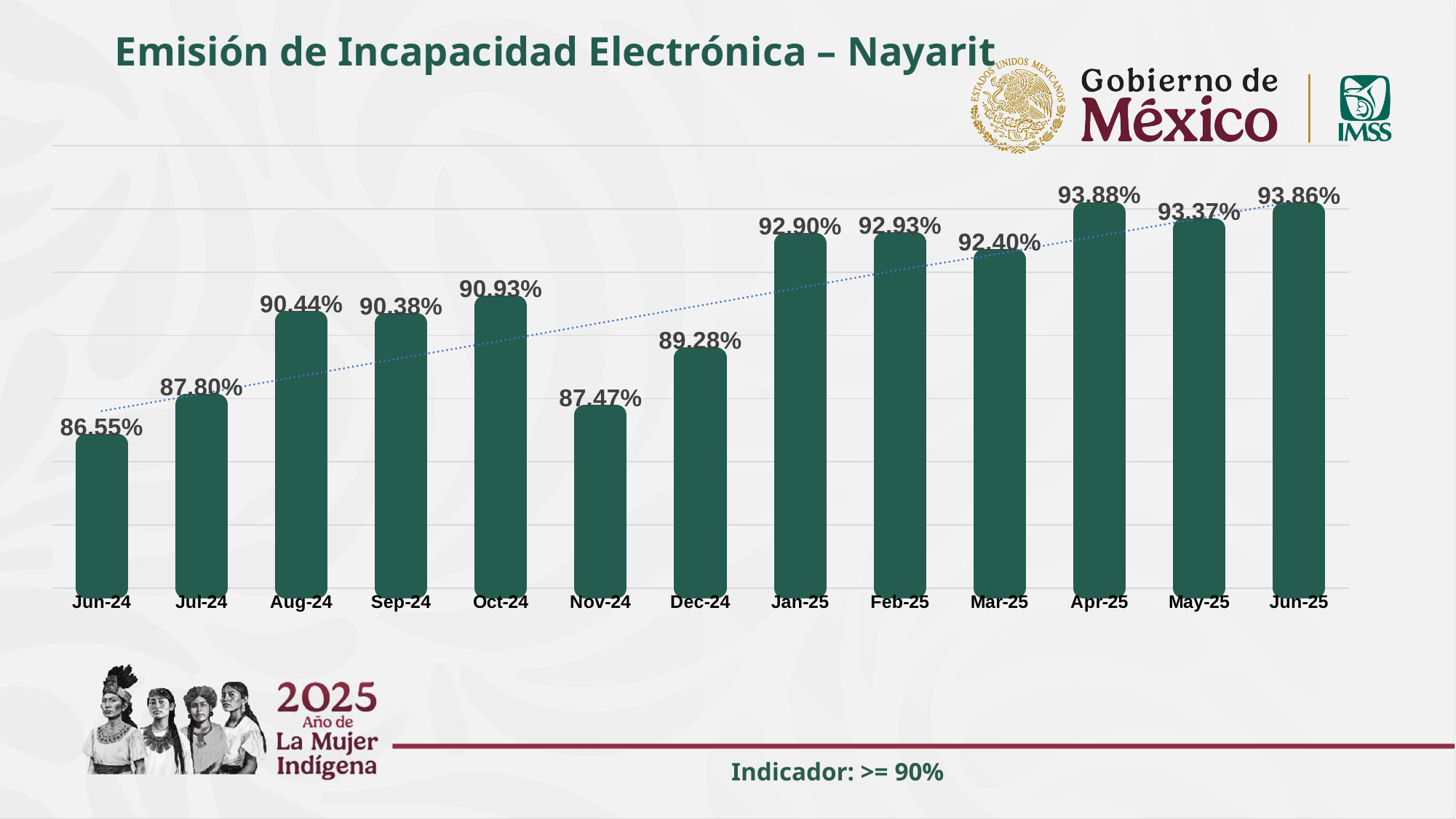
How many months are shown on the x axis? 13 What is the title of the chart? Emisión de Incapacidad Electrónica – Nayarit Which month has the lowest value? Jun-24 What is the value for Jun-25? 93.86% What is the difference between the values for Jun-25 and Jun-24? 7.31 percentage points Which is larger, the value for Oct-24 or the value for Nov-24? Oct-24 What is the difference between the values for Dec-24 and Nov-24? 1.81 percentage points What kind of chart is shown on the slide? Bar chart Do the values generally rise or fall from Jun-24 to Jun-25? Rise What is the value for Jun-24? 86.55% What is the value for Jan-25? 92.90% What is the value for Nov-24? 87.47%